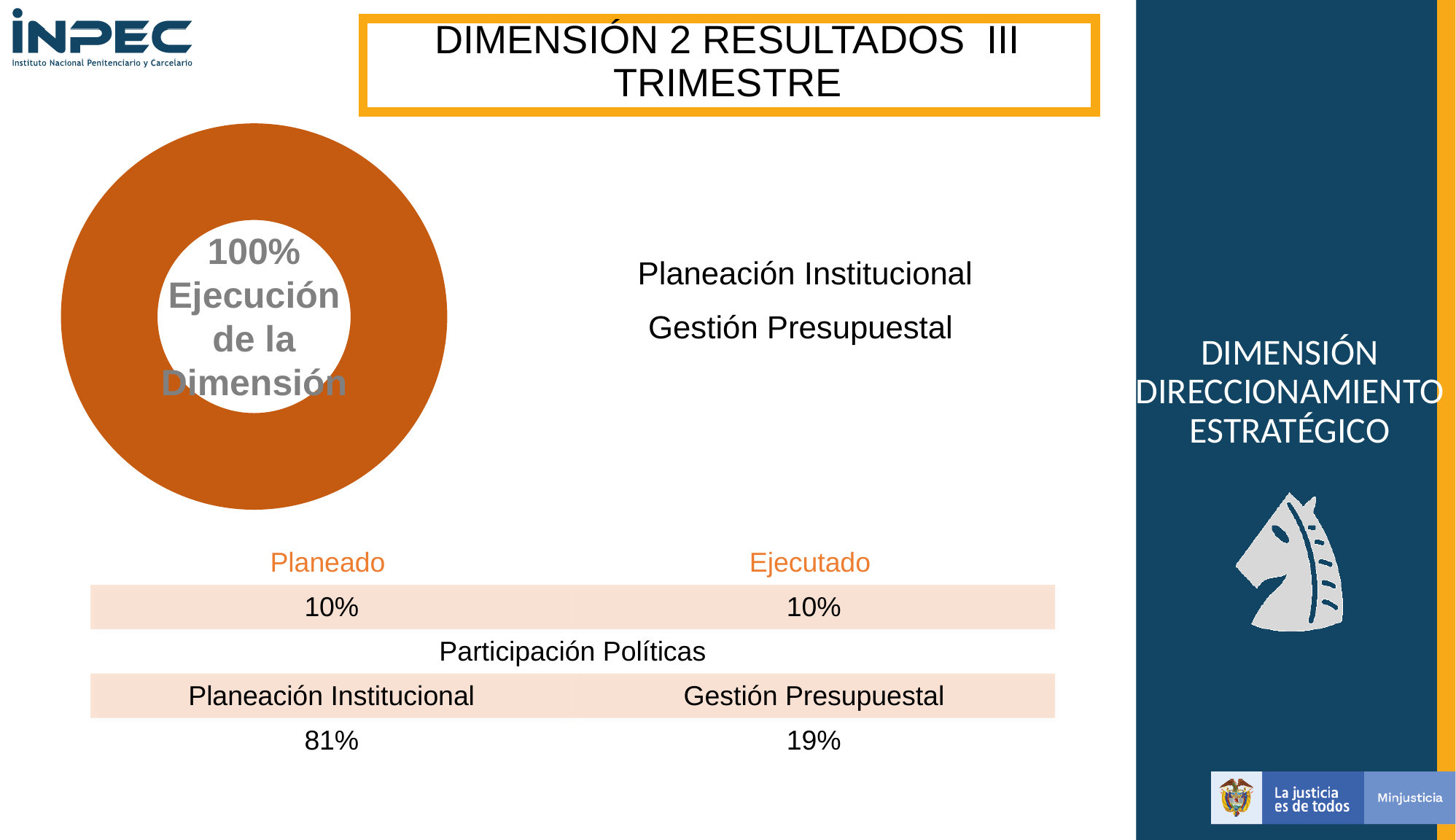
What percentage is printed in the centre of the donut chart? 100% What does the text in the centre of the donut chart say the 100% represents? Ejecución de la Dimensión Is the value shown in the donut chart greater or less than 50%? greater What share of the donut chart does the single slice occupy? 100% What colour is the ring of the donut chart? Orange What kind of chart is shown on the left of the slide? Donut (pie) chart How many distinct slices are visible in the donut chart? 1